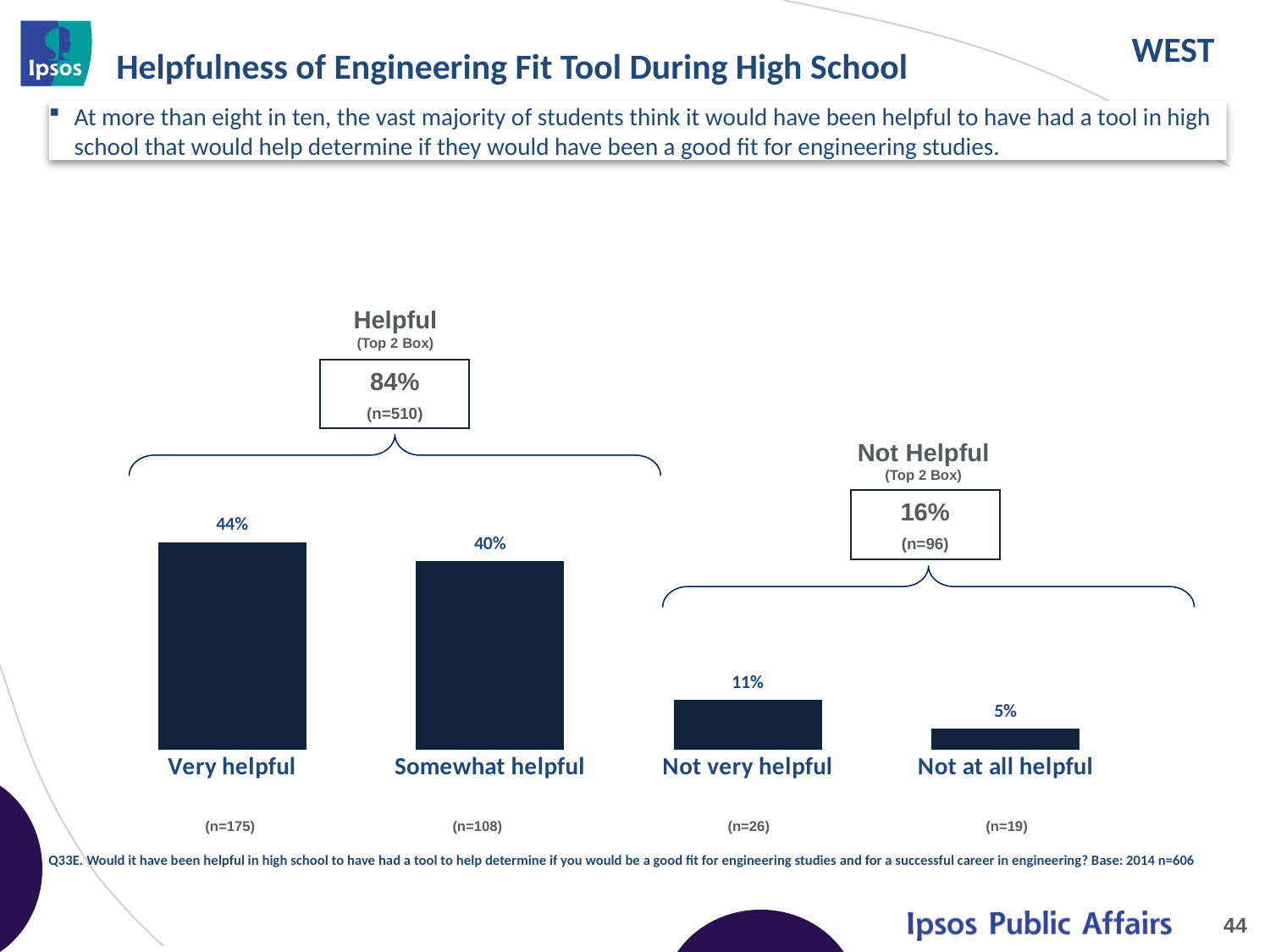
Which category has the highest value? Very helpful What kind of chart is shown on the slide? Bar chart What is the value for Somewhat helpful? 40% What is the Helpful (Top 2 Box) percentage shown above the chart? 84% How many categories are shown in the chart? 4 What percentage of students said the tool would have been very helpful? 44% What is the sample size (n) shown for the Not Helpful (Top 2 Box) group? n=96 What is the value for Not very helpful? 11% Which is larger, the value for Not very helpful or the value for Not at all helpful? Not very helpful What is the value for Not at all helpful? 5% What is the difference between the Very helpful and Somewhat helpful values? 4% Which category has the lowest value? Not at all helpful